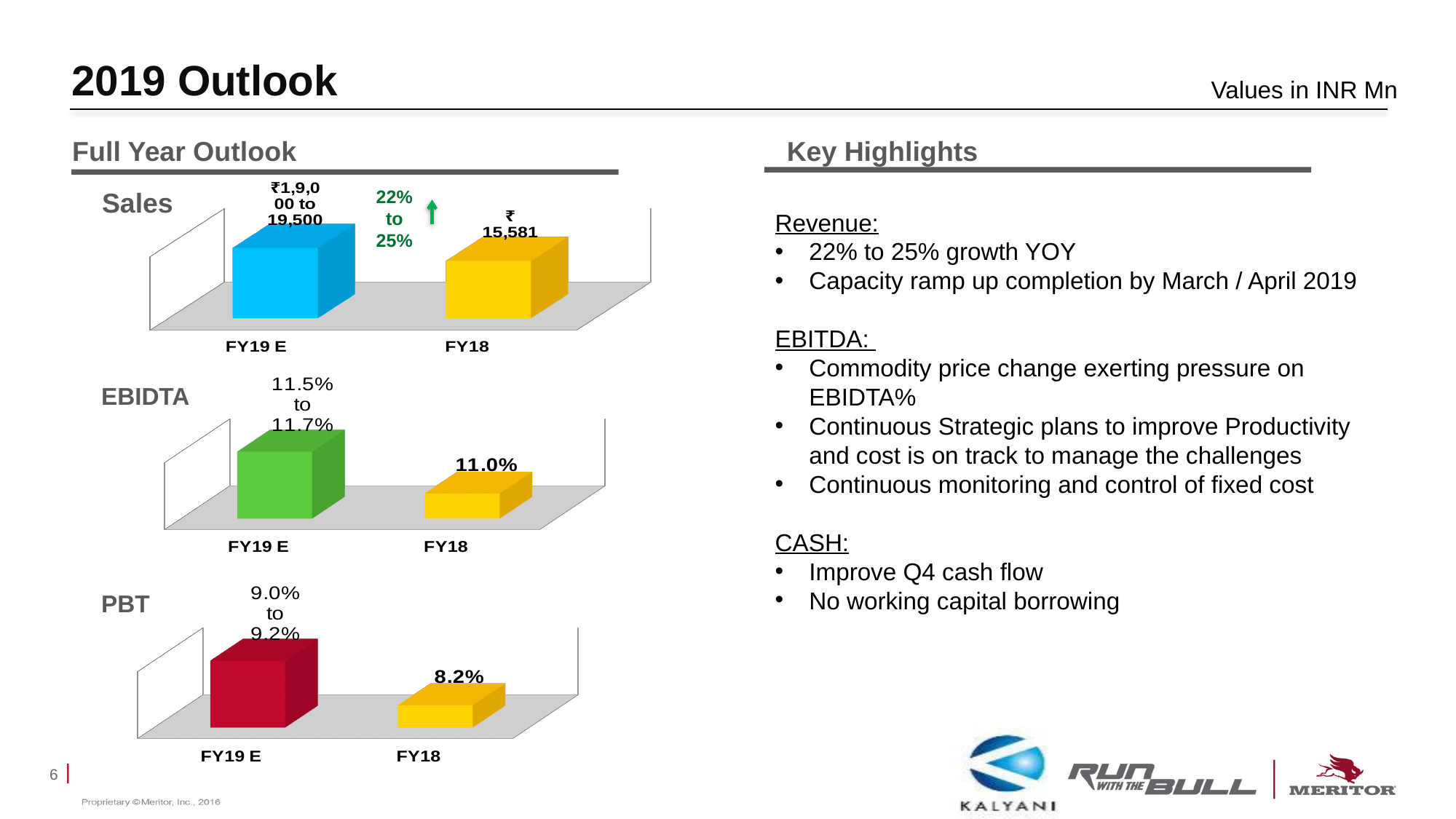
In the PBT chart, what range is shown for FY19 E? 9.0% to 9.2% In the PBT chart, what is the value for FY18? 8.2% In the Sales chart, what growth percentage range is shown between FY18 and FY19 E? 22% to 25% In the PBT chart, which is larger, FY19 E or FY18? FY19 E In the EBIDTA chart, what colour is the FY19 E bar? Green In the Sales chart, what is the value for FY18? ₹ 15,581 In the EBIDTA chart, what range is shown for FY19 E? 11.5% to 11.7% In the Sales chart, which category has the highest value? FY19 E In the EBIDTA chart, which category has the lowest value? FY18 What kind of chart is the Sales chart? Bar chart How many categories are shown in the PBT chart? 2 In the EBIDTA chart, what is the value for FY18? 11.0%